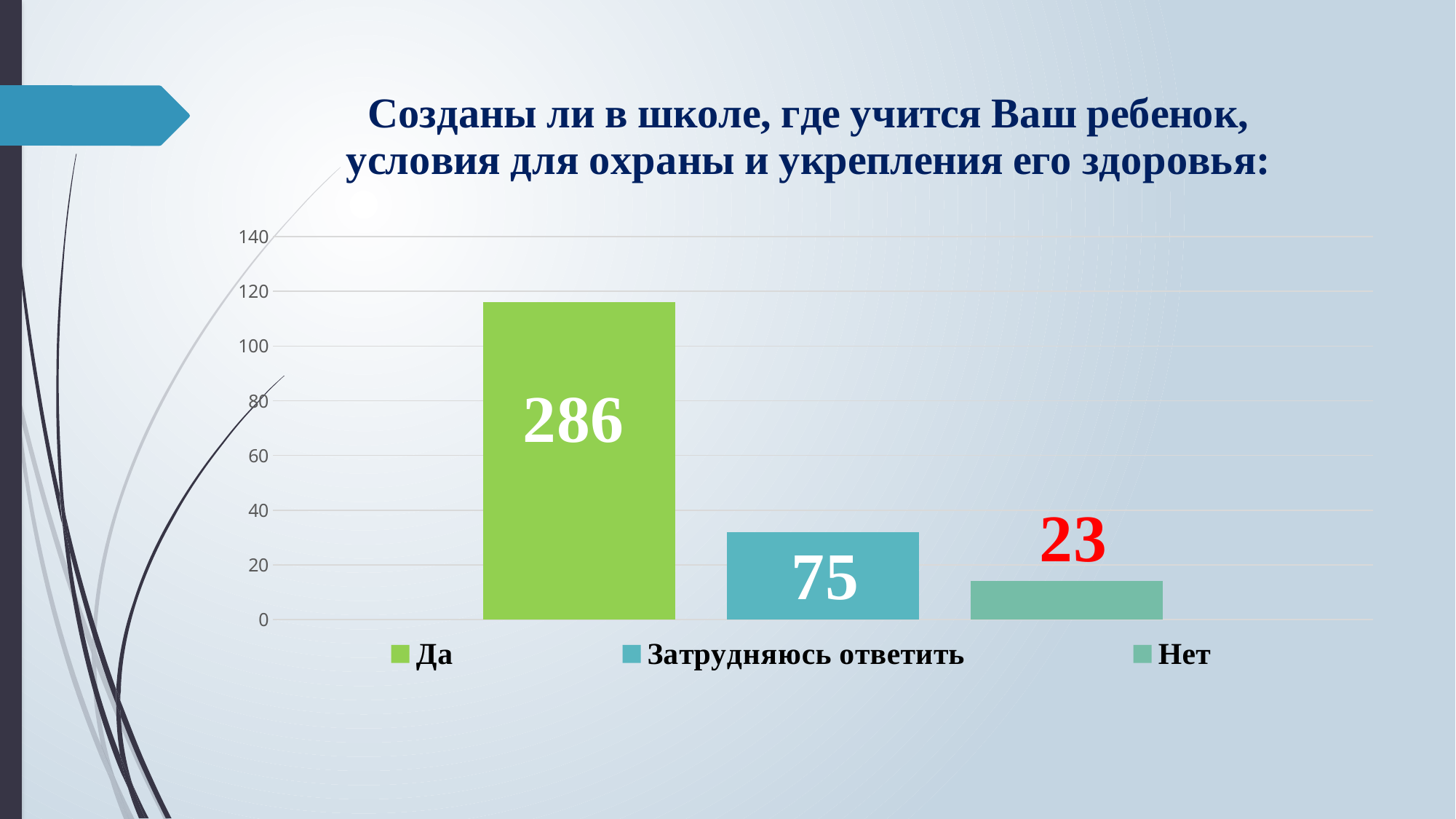
What value is shown for the "Затрудняюсь ответить" bar? 75 Which response category has the highest value? Да How many entries does the legend list? 3 What is the difference between the values for "Да" and "Затрудняюсь ответить"? 211 How many bars are plotted in the chart? 3 Which response category has the lowest value? Нет What is the difference between the values for "Затрудняюсь ответить" and "Нет"? 52 What colour is the "Да" bar? Green What value is shown for the "Да" bar? 286 What kind of chart is shown on the slide? Bar chart What value is shown for the "Нет" bar? 23 Which is larger, the value for "Затрудняюсь ответить" or the value for "Нет"? Затрудняюсь ответить